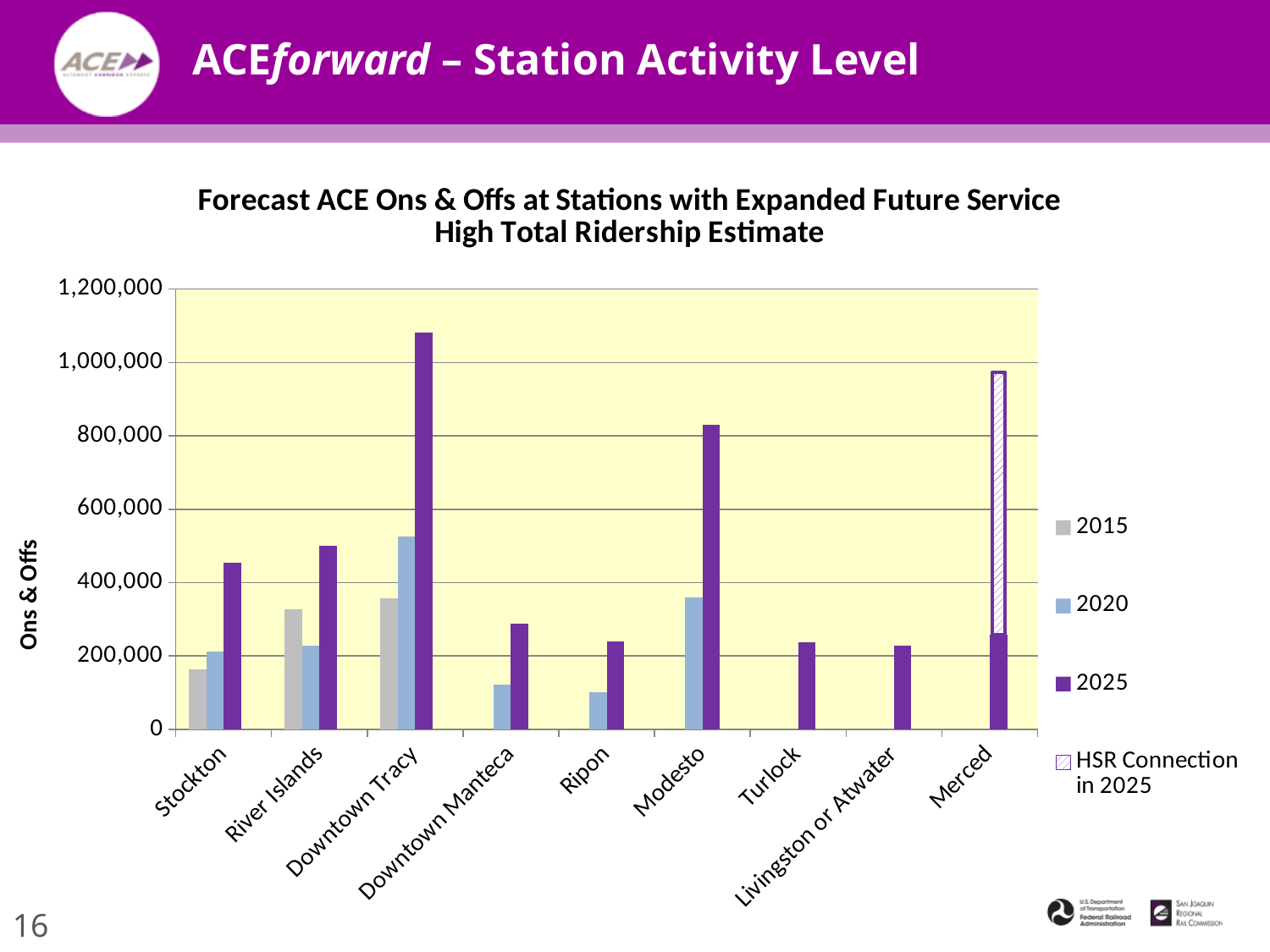
Which is larger, the 2025 value for Modesto or the 2025 value for Stockton? Modesto How many stations are shown on the x axis of the chart? 9 Which station has the highest 2020 value? Downtown Tracy Which is larger, the 2015 value for River Islands or the 2015 value for Stockton? River Islands Is the HSR Connection in 2025 value for Merced greater or less than 1,000,000? less Is the 2020 value for Ripon greater or less than 200,000? less Is the 2025 value for Downtown Tracy greater or less than 1,000,000? greater Which station has the highest 2025 value? Downtown Tracy What kind of chart is shown on the slide? bar chart What is the label on the y axis of the chart? Ons & Offs How many series does the chart's legend list? 4